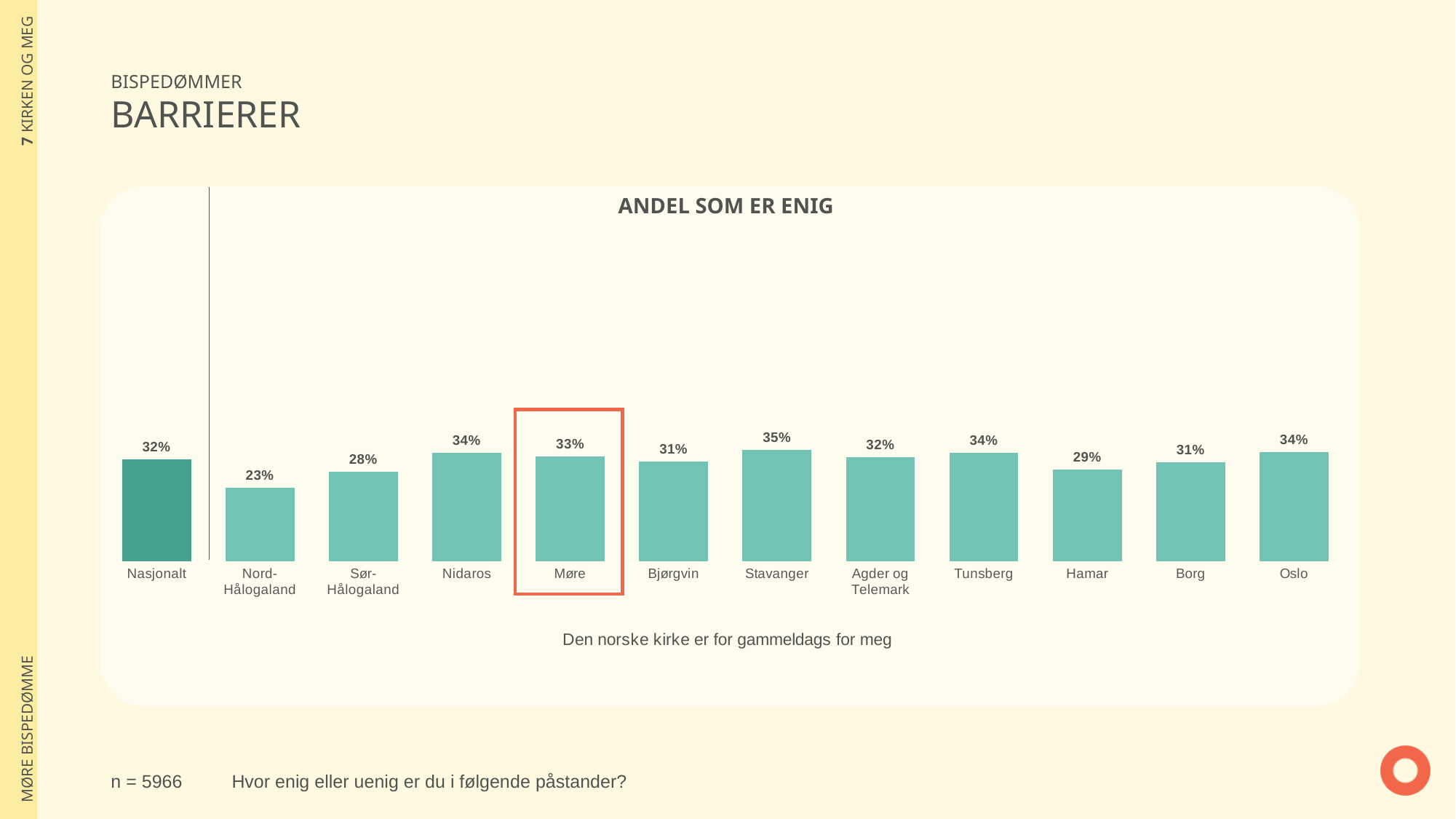
Which category has the highest value? Stavanger Which is larger, the value for Nidaros or the value for Hamar? Nidaros Which category has the lowest value? Nord-Hålogaland What kind of chart is shown on the slide? Bar chart What is the value for Møre? 33% What is the value for Hamar? 29% What is the value for Nasjonalt? 32% What is the value for Nord-Hålogaland? 23% Which bar is highlighted with a red outline? Møre What is the difference between the values for Stavanger and Nord-Hålogaland? 12 percentage points What is the difference between the values for Nidaros and Sør-Hålogaland? 6 percentage points How many bars are shown in the chart? 12